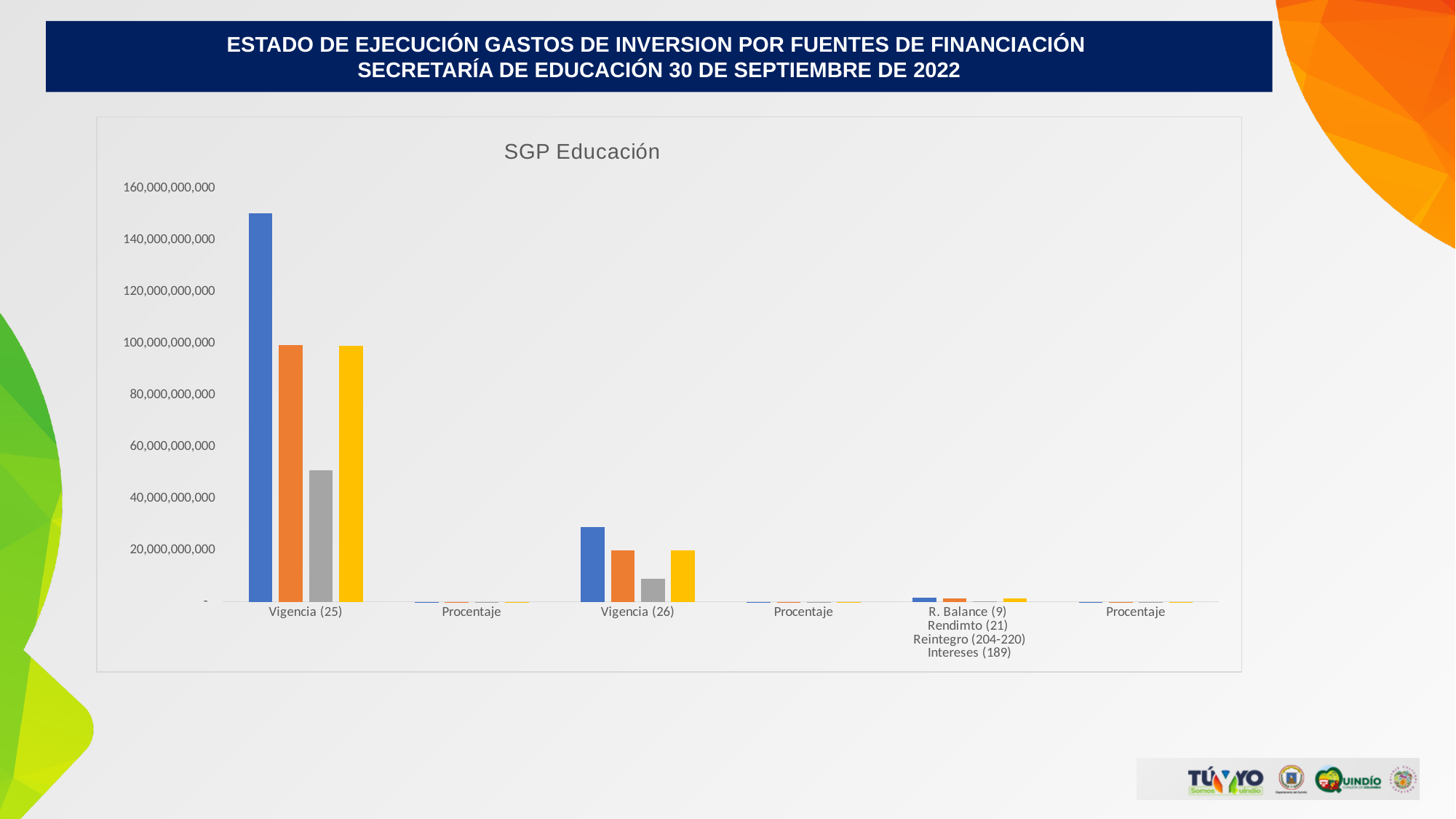
What is the highest value shown on the vertical axis of the chart? 160,000,000,000 Is the value of the orange bar for Vigencia (25) greater or less than 80,000,000,000? greater Is the value of the blue bar for Vigencia (26) greater or less than 20,000,000,000? greater How many categories are shown on the x axis of the chart? 6 What kind of chart is shown on the slide? bar chart How many differently coloured bars are plotted for the Vigencia (25) category? 4 Is the value of the gray bar for Vigencia (25) greater or less than 40,000,000,000? greater Which category has the tallest bar in the chart? Vigencia (25) What is the title of the chart? SGP Educación Which is larger, the blue bar for Vigencia (25) or the blue bar for Vigencia (26)? Vigencia (25)